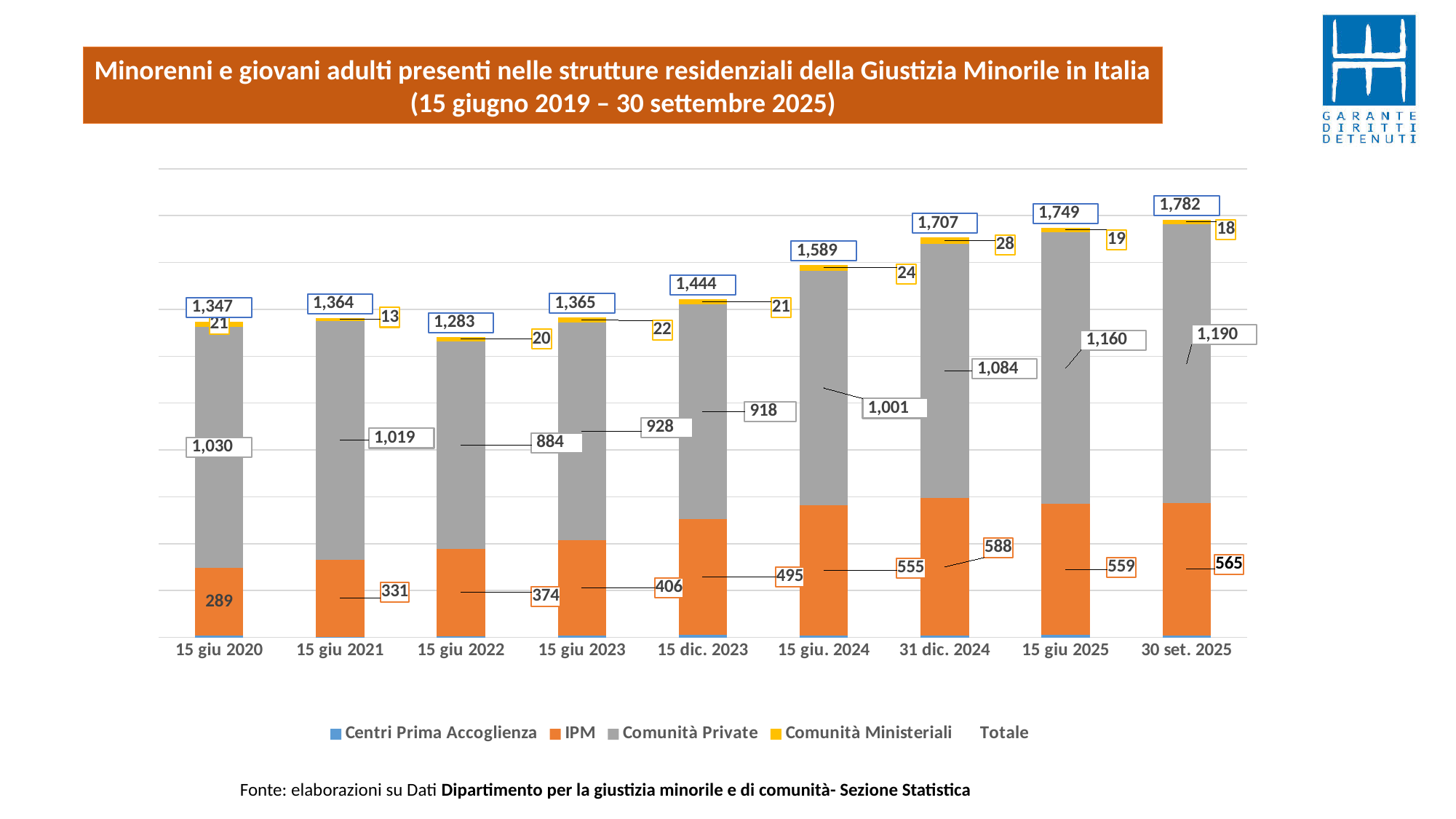
How many dates (categories) are shown on the x axis? 9 What is the source cited below the chart? Dipartimento per la giustizia minorile e di comunità- Sezione Statistica What type of chart is shown on the slide? stacked bar chart What is the difference between the Totale values for 30 set. 2025 and 15 giu 2020? 435 What is the IPM value for 15 giu 2020? 289 What is the Comunità Ministeriali value for 31 dic. 2024? 28 What is the Totale value for 15 giu 2022? 1,283 What is the Comunità Private value for 30 set. 2025? 1,190 Which date has the highest Totale value? 30 set. 2025 Which date has the lowest Comunità Private value? 15 giu 2022 How many series does the legend list? 5 Which is larger, the IPM value for 31 dic. 2024 or for 15 giu 2025? 31 dic. 2024